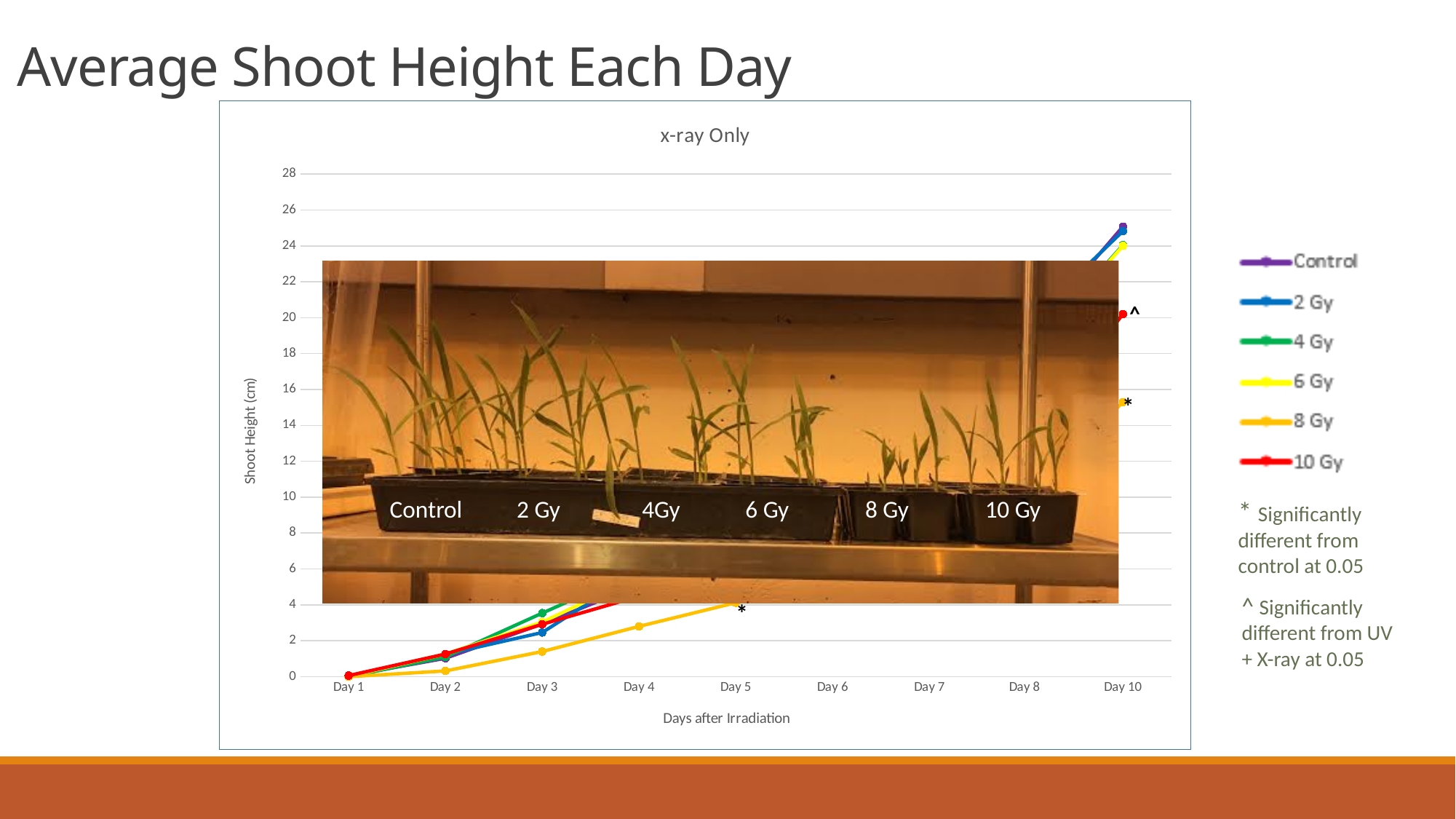
What is the title of the chart? x-ray Only Is the shoot height for 8 Gy at Day 10 greater or less than 20? less Is the shoot height for 8 Gy at Day 4 greater or less than 4? less Do the shoot heights rise or fall from Day 1 to Day 10? rise Is the shoot height for Control at Day 10 greater or less than 22? greater At Day 10, which series has the larger shoot height, 8 Gy or 10 Gy? 10 Gy How many series does the chart legend list? 6 What is the label of the vertical axis of the chart? Shoot Height (cm) How many day categories are shown on the x axis of the chart? 9 What kind of chart is shown on the slide? line chart Which series has the lowest shoot height at Day 10? 8 Gy